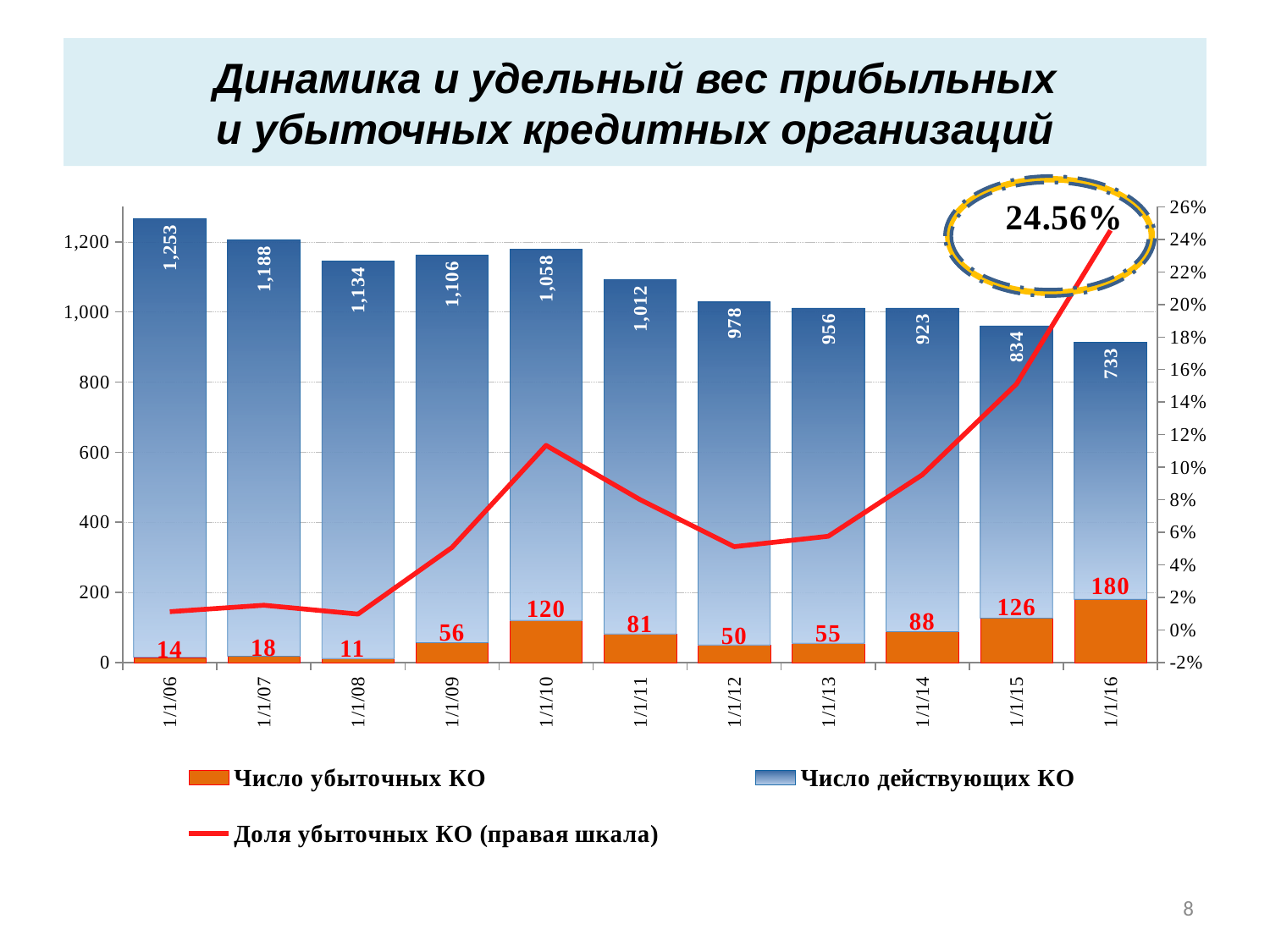
How many series does the legend list? 3 What is the value for Число действующих КО at 1/1/06? 1,253 What value is labelled on the Доля убыточных КО line at 1/1/16? 24.56% How many dates are shown on the x axis? 11 At which date is Число убыточных КО the highest? 1/1/16 What is the total of the stacked bar at 1/1/16 (Число убыточных КО plus Число действующих КО)? 913 Which is larger, Число убыточных КО at 1/1/11 or at 1/1/14? 1/1/14 What is the value for Число действующих КО at 1/1/16? 733 At which date is Число убыточных КО the lowest? 1/1/08 What is the value for Число убыточных КО at 1/1/10? 120 Does Число действующих КО rise or fall from 1/1/06 to 1/1/16? fall What is the difference between Число действующих КО at 1/1/06 and at 1/1/16? 520